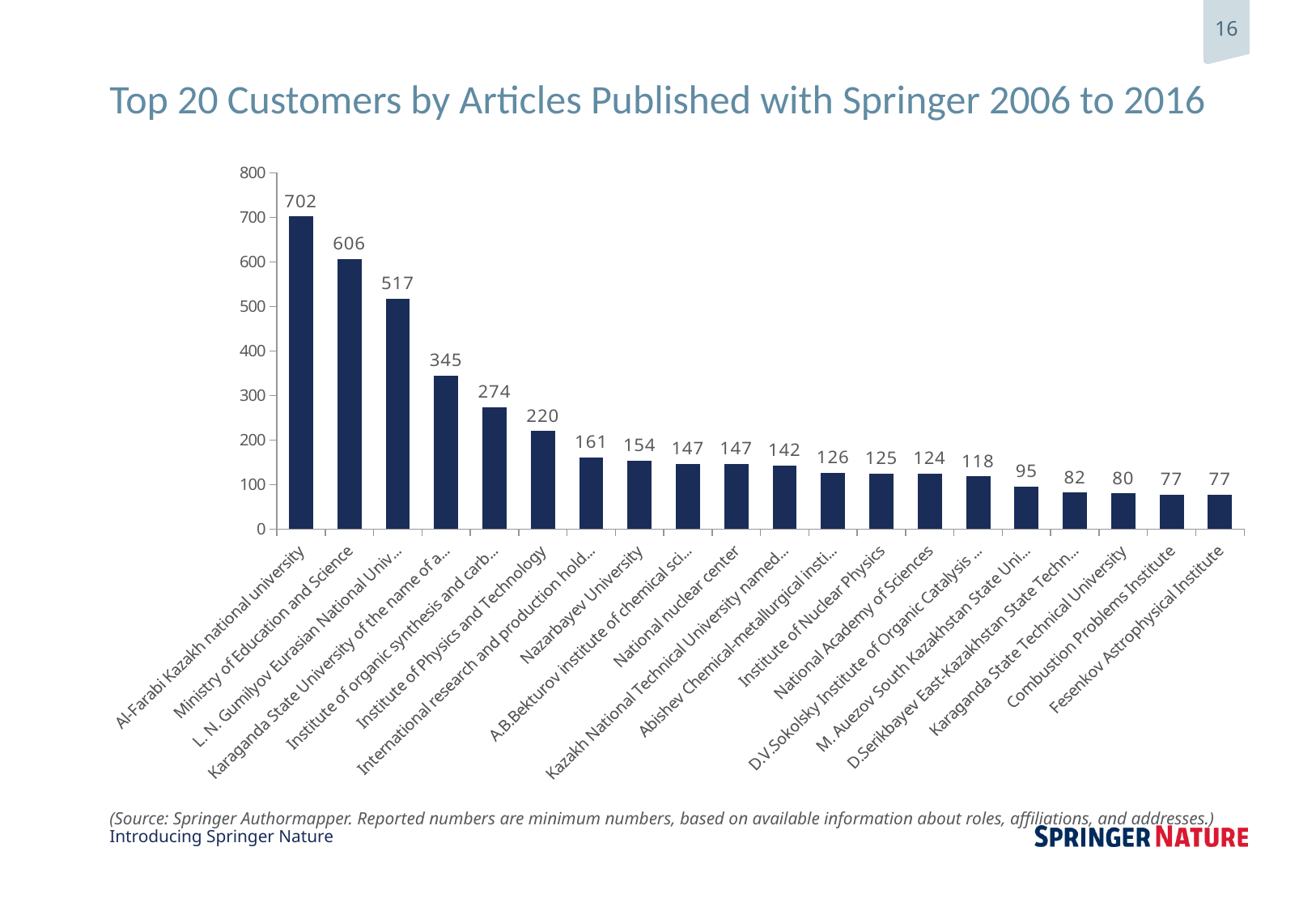
What is the value for Institute of Nuclear Physics? 125 How many articles were published by Al-Farabi Kazakh national university? 702 What kind of chart is shown on the slide? bar chart What is the value for Nazarbayev University? 154 What is the lowest value shown on the chart? 77 What is the difference between the values for Al-Farabi Kazakh national university and Ministry of Education and Science? 96 Do the values rise or fall from left to right along the x axis? fall How many customers are shown on the chart? 20 What is the value for Institute of Physics and Technology? 220 Which customer has the highest number of articles published? Al-Farabi Kazakh national university Which is larger, the value for National nuclear center or the value for National Academy of Sciences? National nuclear center Is the value for Combustion Problems Institute greater or less than 100? less